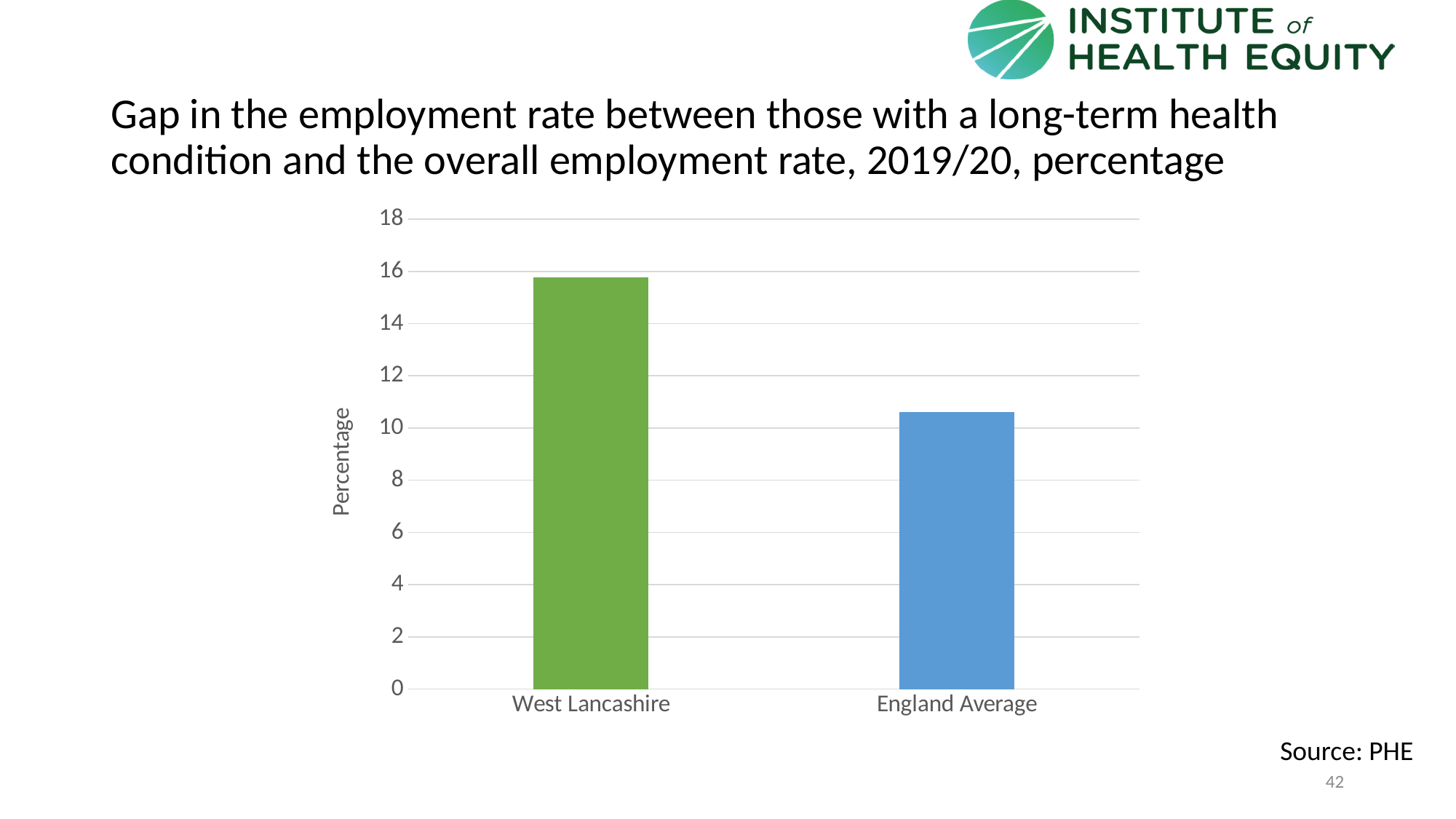
Is the value for England Average greater or less than 12? less Which category has the highest value? West Lancashire Which is larger, the value for West Lancashire or the value for England Average? West Lancashire Is the value for West Lancashire greater or less than 14? greater What is the highest value shown on the vertical axis? 18 What kind of chart is shown on the slide? bar chart Is the value for England Average greater or less than 10? greater Which category has the lowest value? England Average What is the label of the vertical axis? Percentage What is the source cited for the chart? PHE How many categories are plotted on the chart? 2